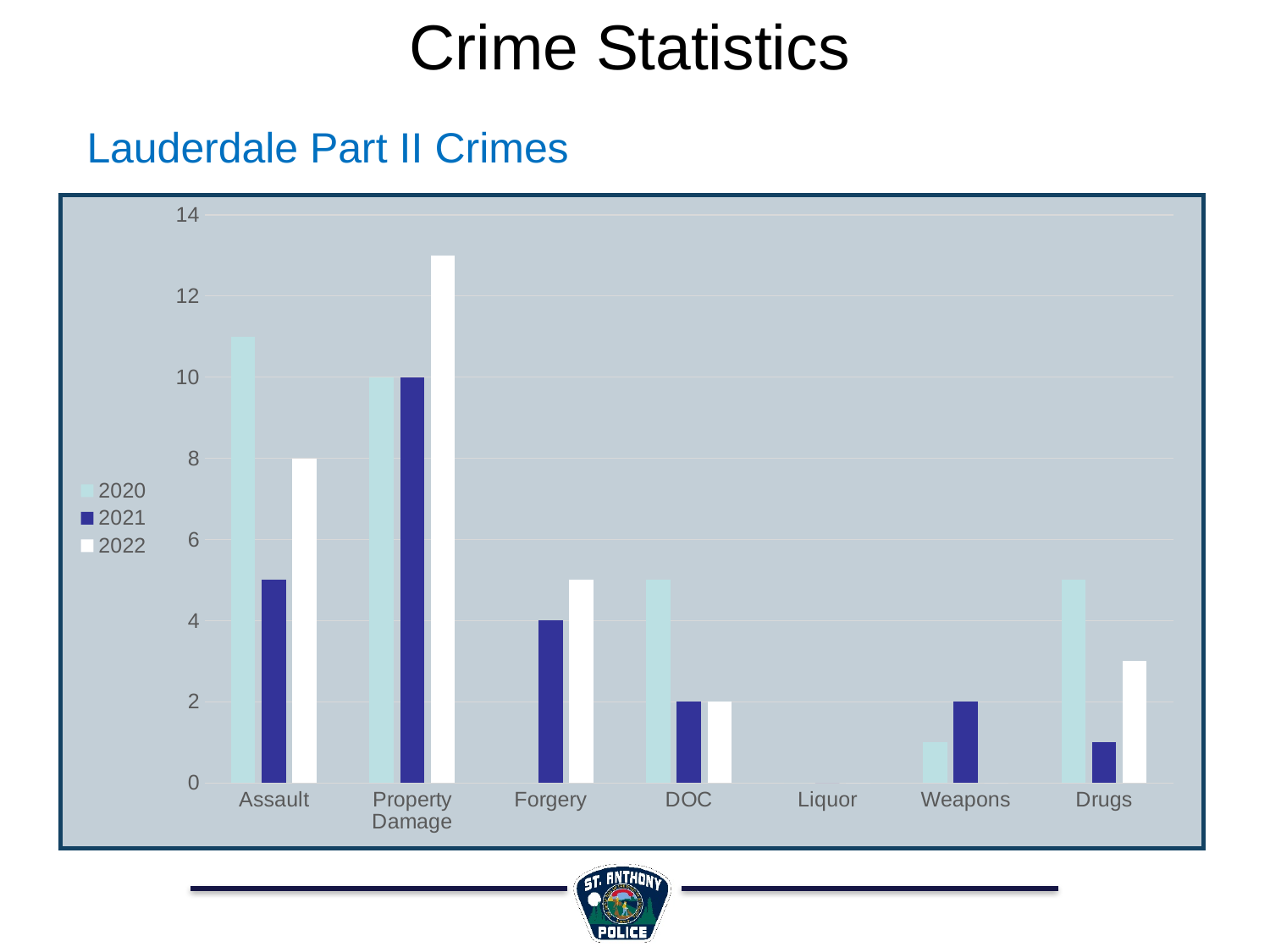
What is the 2021 value for Weapons? 2 Which is larger, the 2020 value for Assault or the 2022 value for Assault? 2020 What is the 2021 value for Forgery? 4 How many series does the legend list? 3 What is the 2022 value for Assault? 8 What is the difference between the 2020 value for Property Damage and the 2021 value for Forgery? 6 What type of chart is shown on the slide? bar chart How many crime categories are shown on the x axis? 7 Which category has no visible bars for any year? Liquor Is the 2022 value for Property Damage greater or less than 12? greater Which category has the tallest bar in the chart? Property Damage What is the 2020 value for Property Damage? 10